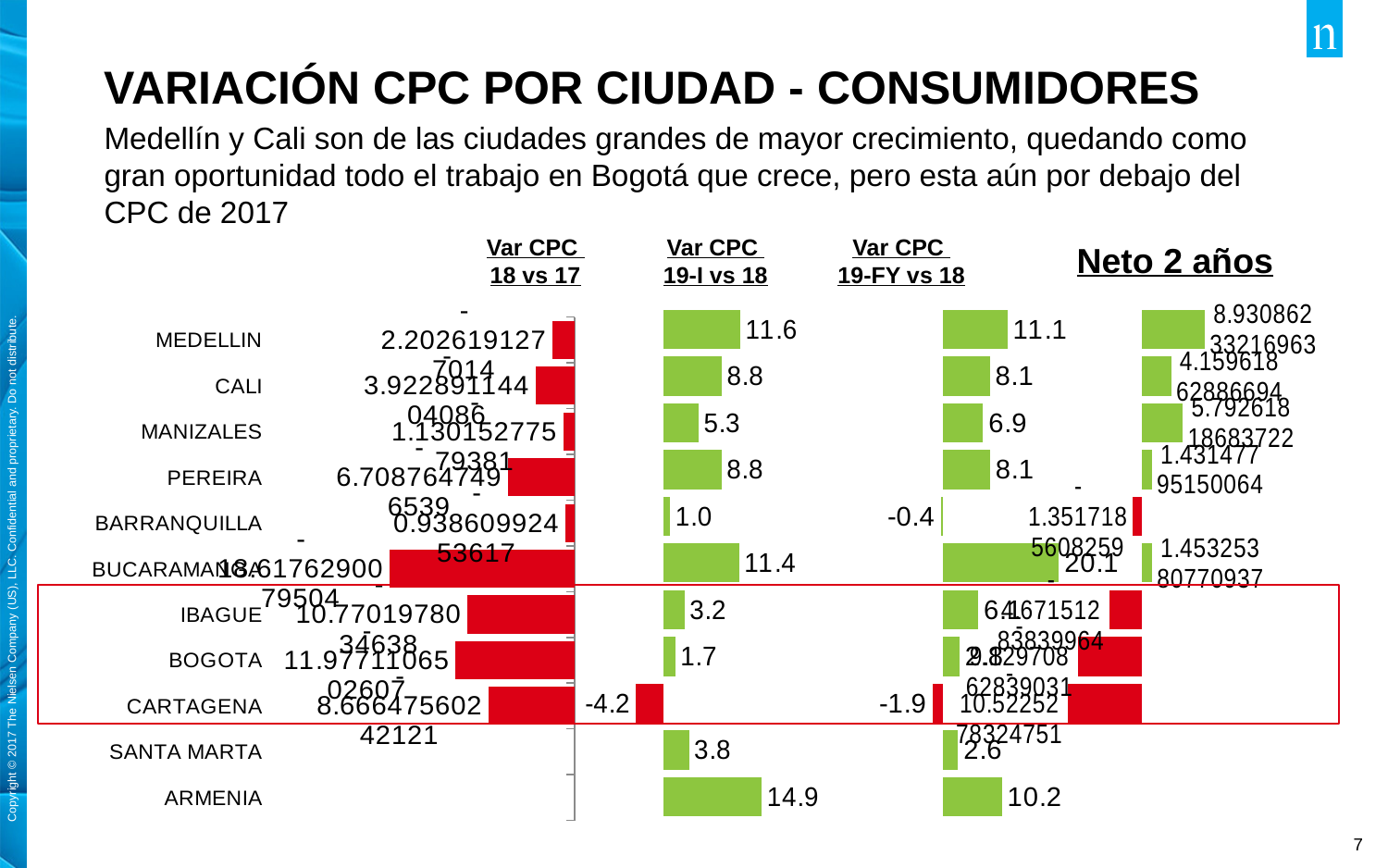
In the 'Var CPC 19-I vs 18' chart, which city has the highest value? ARMENIA How many cities are listed on the slide's charts? 11 In the 'Var CPC 19-I vs 18' chart, what is the value for CARTAGENA? -4.2 In the 'Var CPC 19-I vs 18' chart, what is the value for MEDELLIN? 11.6 In the 'Var CPC 19-I vs 18' chart, which is larger, the value for BOGOTA or the value for IBAGUE? IBAGUE In the 'Var CPC 19-I vs 18' chart, what is the value for ARMENIA? 14.9 In the 'Var CPC 19-FY vs 18' chart, which city has the highest value? BUCARAMANGA In the 'Var CPC 19-I vs 18' chart, which city has the lowest value? CARTAGENA In the 'Var CPC 19-FY vs 18' chart, what is the difference between the values for MEDELLIN and ARMENIA? 0.9 In the 'Var CPC 19-FY vs 18' chart, what is the value for BARRANQUILLA? -0.4 In the 'Var CPC 19-FY vs 18' chart, what is the value for BUCARAMANGA? 20.1 What kind of chart is used for 'Var CPC 19-I vs 18'? Bar chart